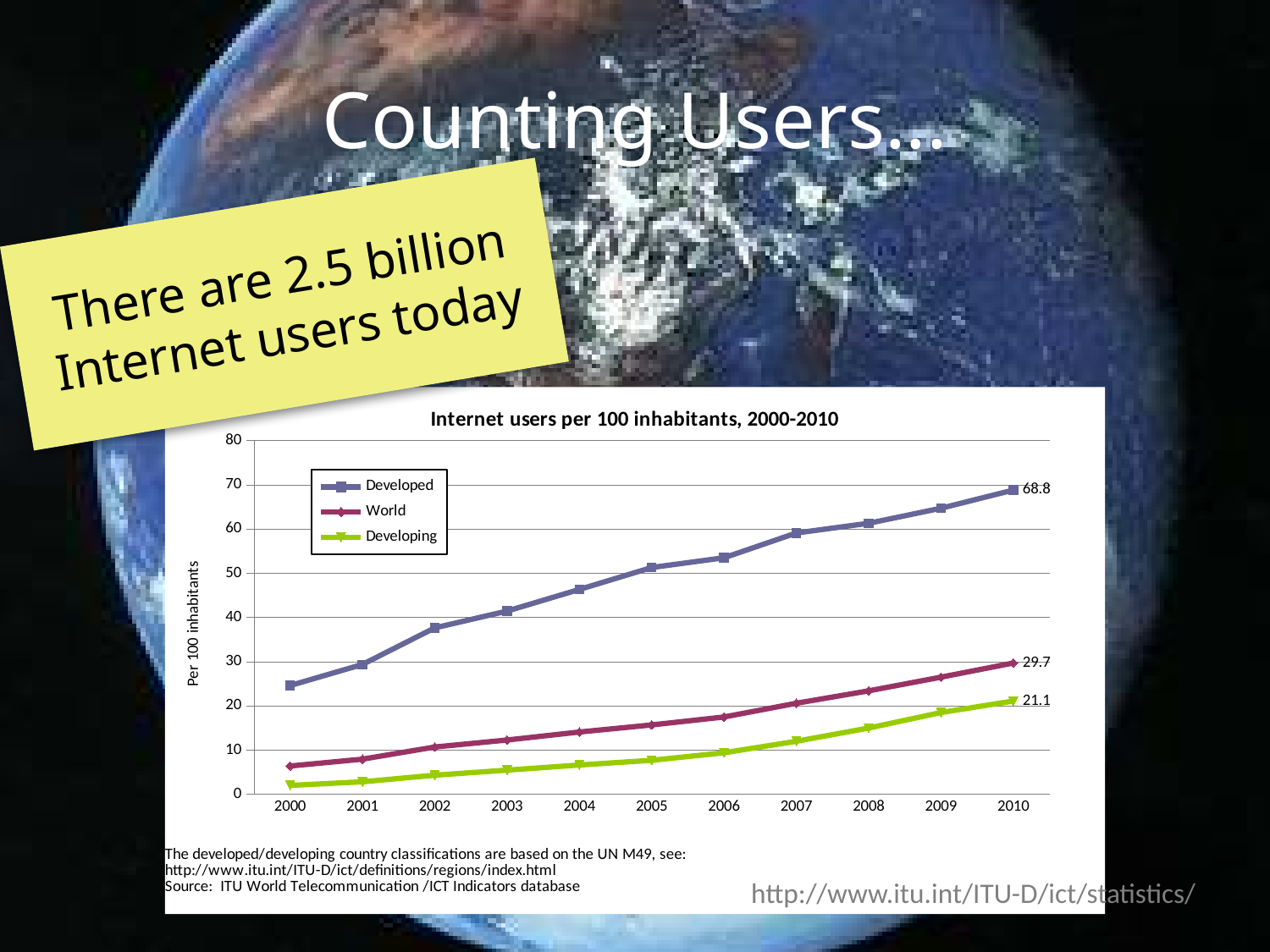
What is the difference between the Developed and Developing values in 2010? 47.7 Is the value for Developed in 2000 greater or less than 20? greater Is the value for World in 2005 greater or less than 20? less What is the value for Developed in 2010? 68.8 What is the value for World in 2010? 29.7 Which series has the highest value in 2010? Developed What is the value for Developing in 2010? 21.1 How many series does the legend list? 3 Which series has the lowest value in 2000? Developing What is the difference between the World and Developing values in 2010? 8.6 What kind of chart is shown? Line chart Do the Developed values rise or fall from 2000 to 2010? Rise